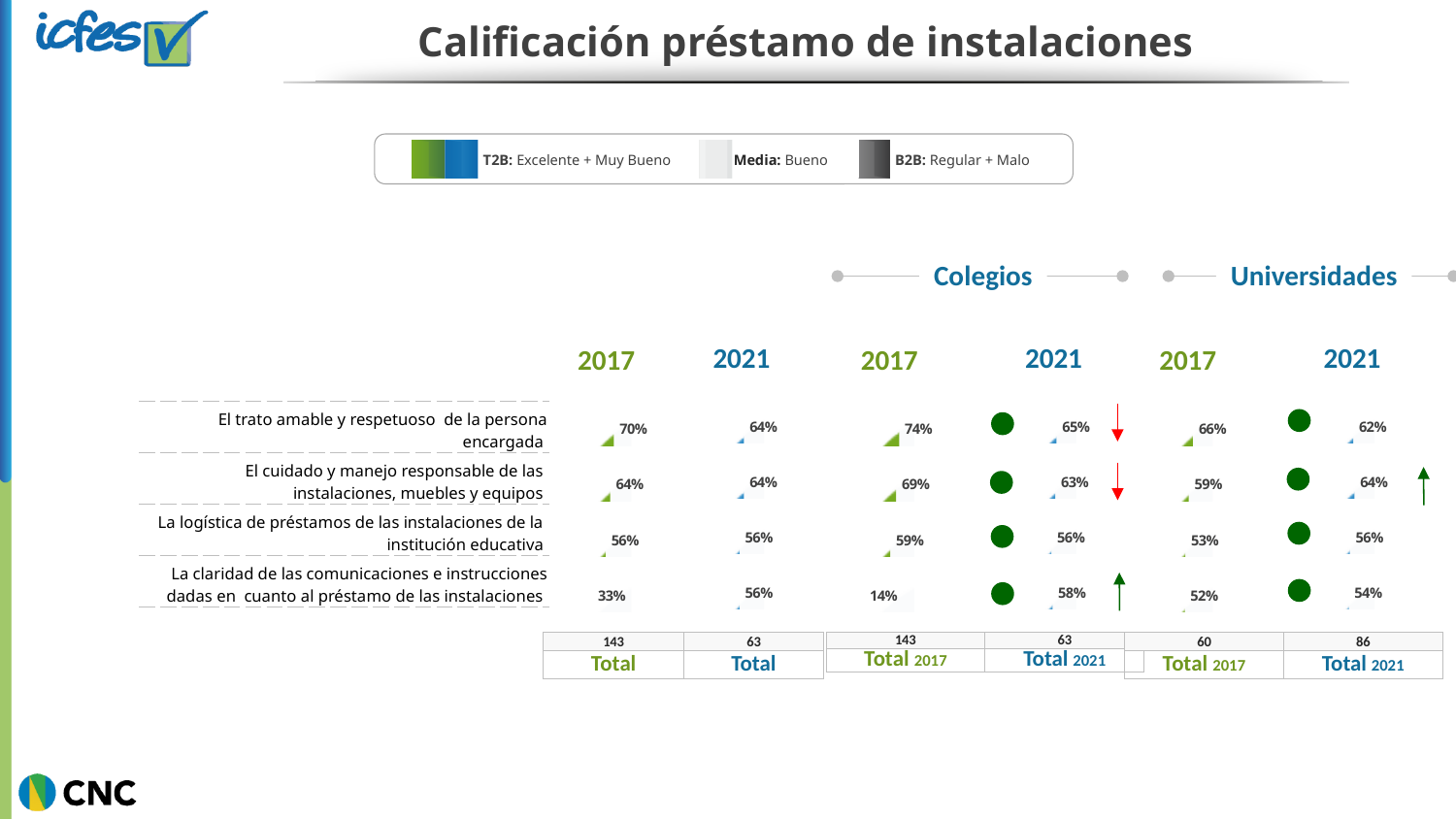
For "La claridad de las comunicaciones e instrucciones dadas en cuanto al préstamo de las instalaciones", which is larger: the Colegios 2017 value or the Colegios 2021 value? Colegios 2021 What is the base (n) shown for Universidades Total 2021? 86 What is the Universidades 2017 value for "El cuidado y manejo responsable de las instalaciones, muebles y equipos"? 59% What is the difference between the Total 2017 and Total 2021 values for "El trato amable y respetuoso de la persona encargada"? 6% Which attribute has the lowest Total 2017 value? La claridad de las comunicaciones e instrucciones dadas en cuanto al préstamo de las instalaciones What is the title of the slide? Calificación préstamo de instalaciones What is the Colegios 2021 value for "La claridad de las comunicaciones e instrucciones dadas en cuanto al préstamo de las instalaciones"? 58% According to the legend, what does T2B stand for? Excelente + Muy Bueno Which attribute has the highest Colegios 2017 value? El trato amable y respetuoso de la persona encargada How many attributes (rows) are rated in the chart? 4 What is the Total 2017 value for "El trato amable y respetuoso de la persona encargada"? 70% What is the Colegios 2017 value for "La claridad de las comunicaciones e instrucciones dadas en cuanto al préstamo de las instalaciones"? 14%